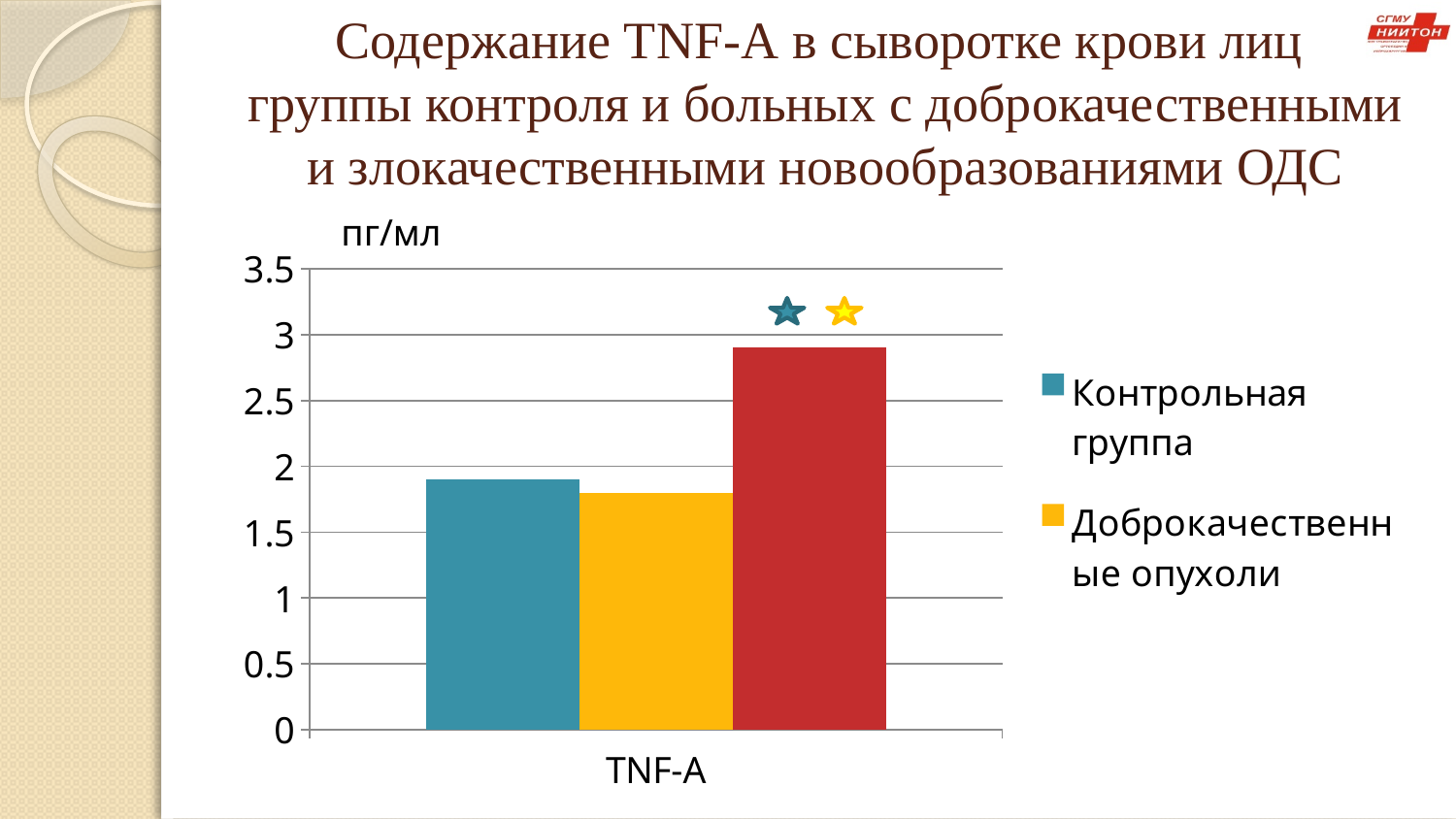
Which bar is the tallest in the chart? the red bar Is the value for Доброкачественные опухоли greater or less than 1.5? greater What kind of chart is shown on the slide? bar chart What unit is shown above the y axis of the chart? пг/мл Is the value for Контрольная группа greater or less than 2? less Is the value for Контрольная группа greater or less than 1.5? greater How many categories are shown on the x axis of the chart? 1 Which is larger, the value for Контрольная группа or the value for Доброкачественные опухоли? Контрольная группа What is the category label on the x axis of the chart? TNF-A